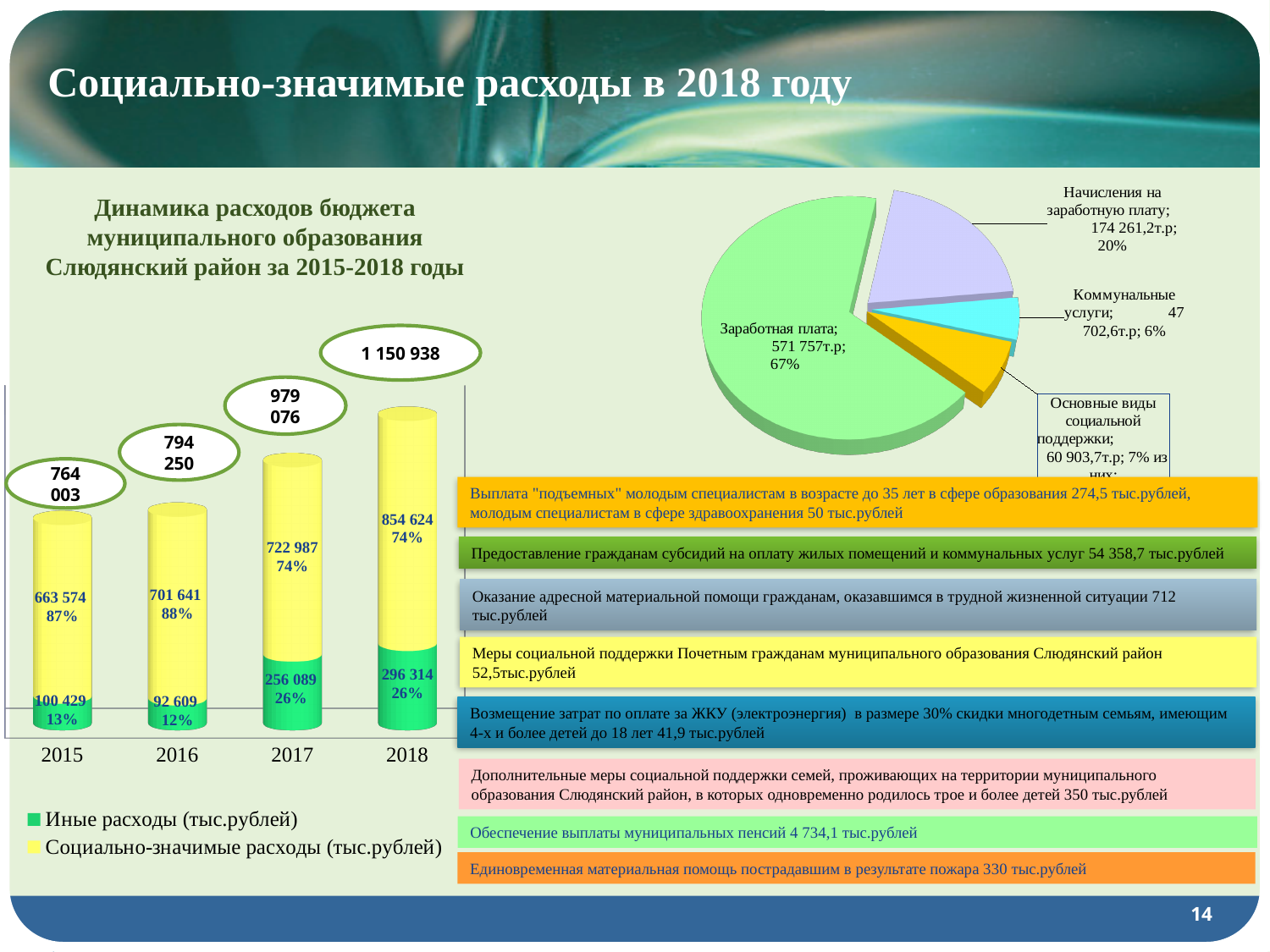
In the pie chart on the right, what is the value for 'Коммунальные услуги'? 47 702,6т.р In the bar chart on the left, what is the difference between 'Социально-значимые расходы' in 2018 and in 2017? 131 637 In the pie chart on the right, what share does 'Заработная плата' have? 67% In the bar chart on the left, which year has the lowest value of 'Иные расходы'? 2016 In the bar chart on the left, what is the total shown above the bar for 2017? 979 076 In the bar chart on the left, how many series does the legend list? 2 In the pie chart on the right, which slice is the smallest? Коммунальные услуги In the bar chart 'Динамика расходов бюджета муниципального образования Слюдянский район за 2015-2018 годы', what is the value of 'Социально-значимые расходы' for 2018? 854 624 In the bar chart on the left, what is the value of 'Иные расходы' for 2016? 92 609 In the bar chart on the left, do the total expenditures rise or fall from 2015 to 2018? rise In the bar chart on the left, what percentage share do 'Иные расходы' make up in 2015? 13% In the bar chart on the left, which year has the highest total expenditure? 2018